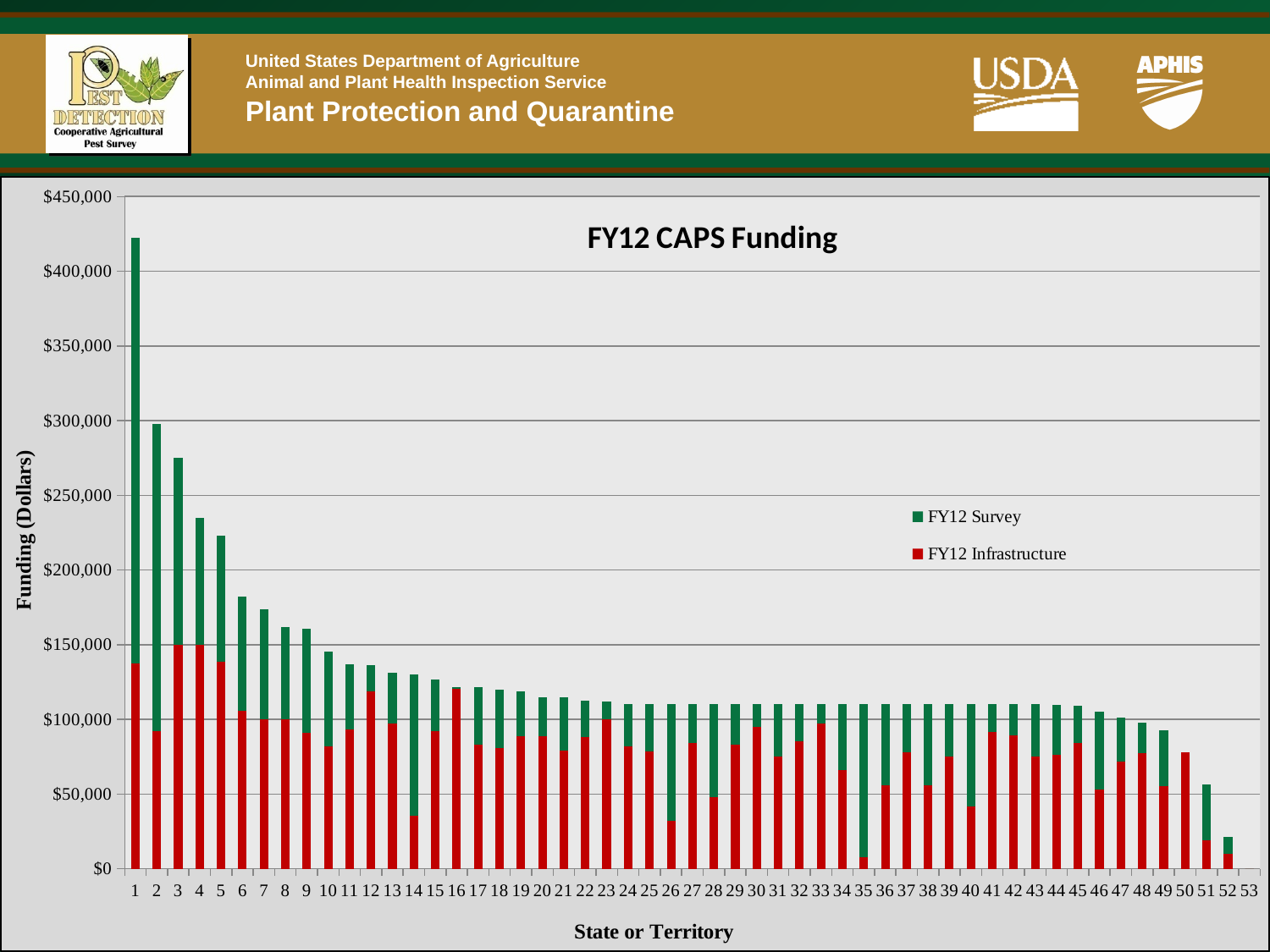
Which state or territory number has the lowest total funding? 53 Is the total funding for state or territory 53 greater or less than $50,000? less How many series does the legend list? 2 Is the total funding for state or territory 3 greater or less than $250,000? greater What is the title of the chart? FY12 CAPS Funding Is the FY12 Infrastructure value for state or territory 35 greater or less than $50,000? less How many states or territories are plotted along the x axis? 53 Do the total funding values rise or fall moving from left to right along the x axis? Fall What are the two series named in the legend? FY12 Survey and FY12 Infrastructure What kind of chart is shown on the slide? Stacked bar chart Which state or territory number has the highest total funding? 1